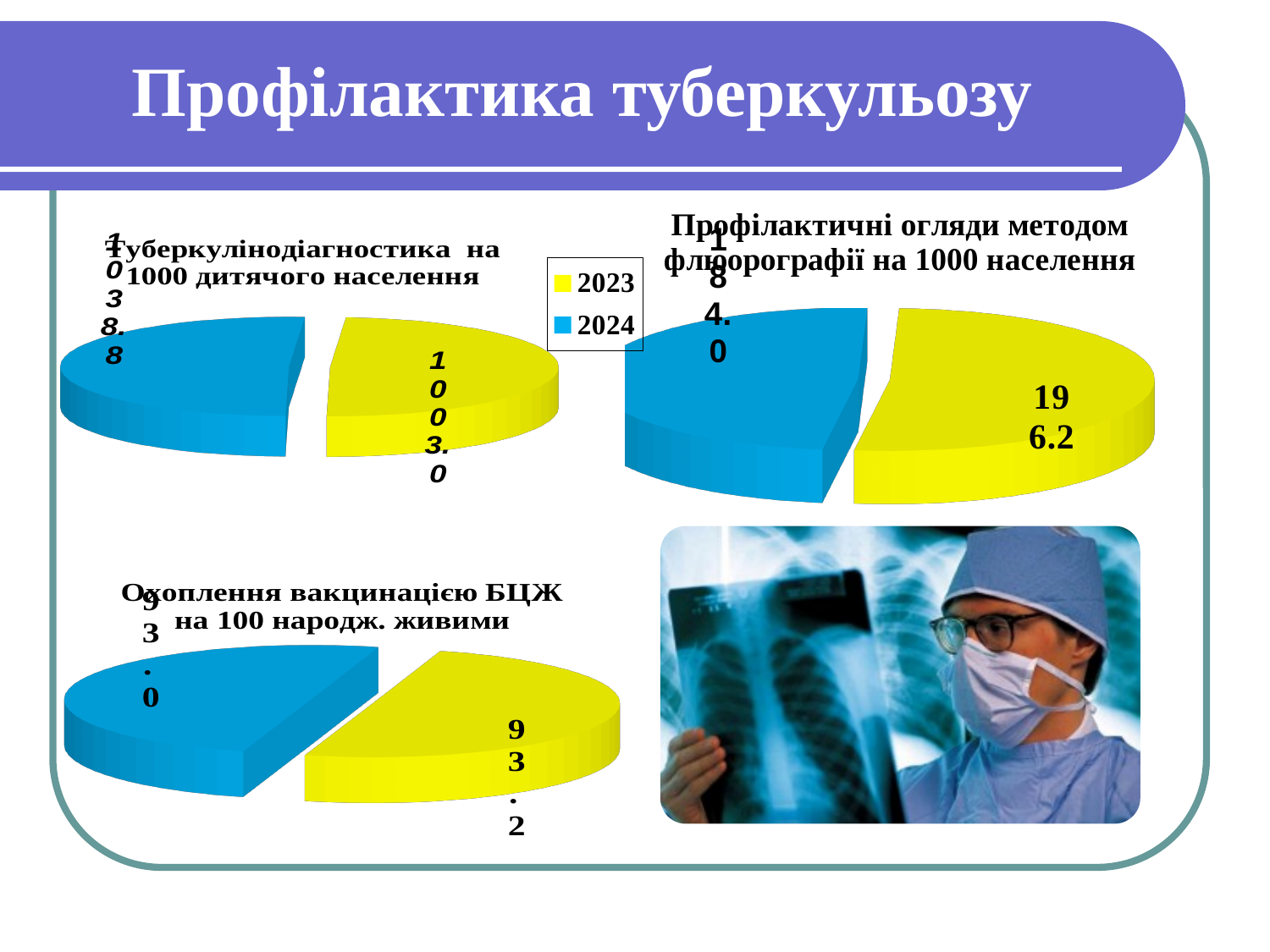
In the chart 'Туберкулінодіагностика на 1000 дитячого населення', which year has the higher value? 2024 Which colour represents 2024 in the legend? blue In the chart 'Профілактичні огляди методом флюорографії на 1000 населення', what is the value for 2024? 184.0 In the chart 'Профілактичні огляди методом флюорографії на 1000 населення', what is the value for 2023? 196.2 How many series does the legend list? 2 In the chart 'Туберкулінодіагностика на 1000 дитячого населення', what is the value for 2023? 1003.0 What kind of chart is used for 'Туберкулінодіагностика на 1000 дитячого населення'? pie chart In the chart 'Туберкулінодіагностика на 1000 дитячого населення', what is the value for 2024? 1038.8 In the chart 'Охоплення вакцинацією БЦЖ на 100 народж. живими', what is the value for 2024? 93.0 How many pie charts are shown on the slide? 3 In the chart 'Охоплення вакцинацією БЦЖ на 100 народж. живими', what is the value for 2023? 93.2 In the chart 'Профілактичні огляди методом флюорографії на 1000 населення', what is the difference between the 2023 and 2024 values? 12.2